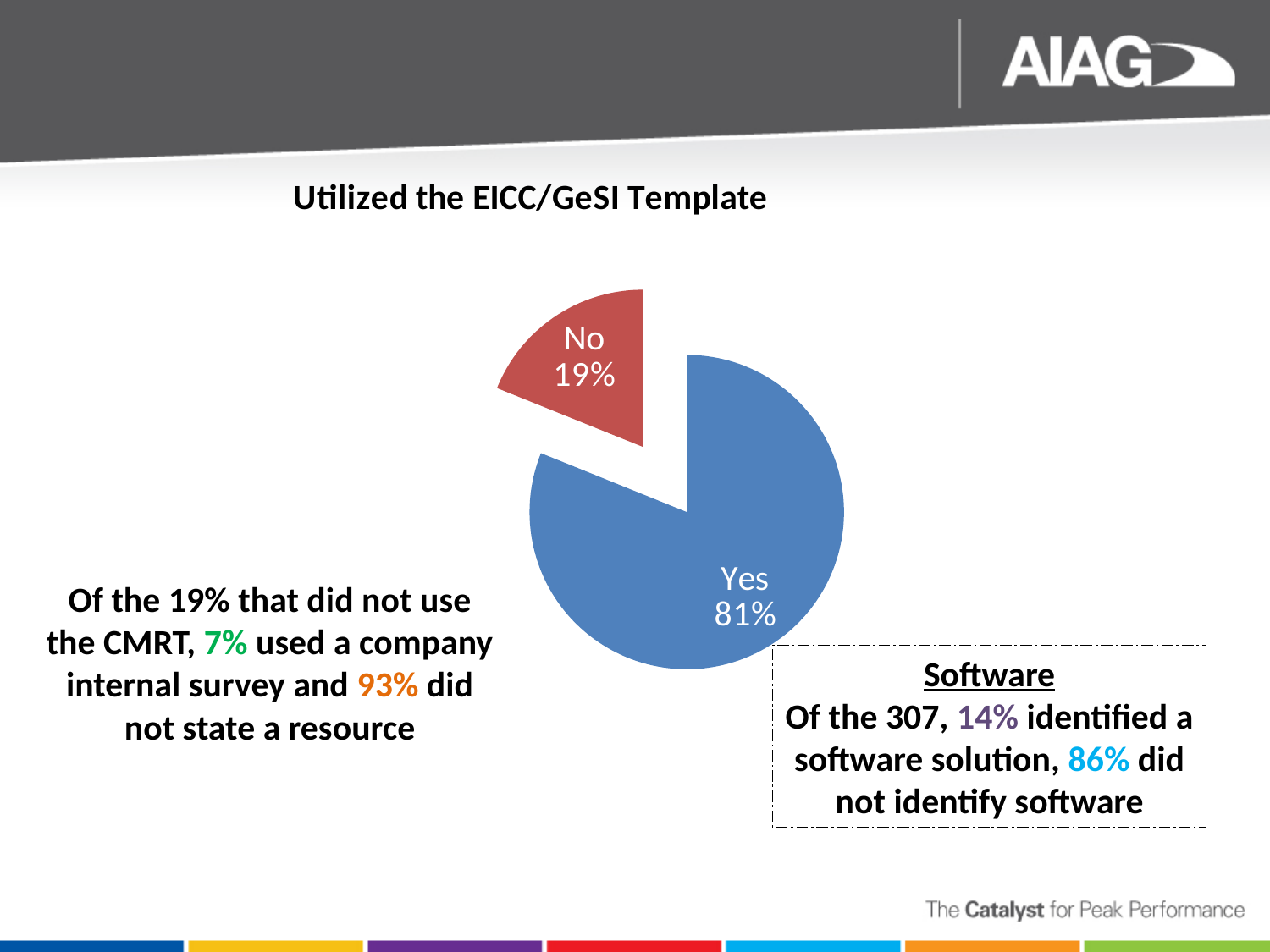
How many slices does the pie chart have? 2 What is the title of the chart? Utilized the EICC/GeSI Template What percentage of respondents answered No to utilizing the EICC/GeSI Template? 19% What percentage of respondents answered Yes to utilizing the EICC/GeSI Template? 81% Which slice of the pie chart is the largest? Yes What is the difference in percentage points between the Yes and No slices? 62 Which slice of the pie chart is the smallest? No Which is larger, the Yes slice or the No slice? Yes What colour is the Yes slice of the pie chart? Blue What share of the pie does the No slice represent? 19% What kind of chart is shown on the slide? Pie chart